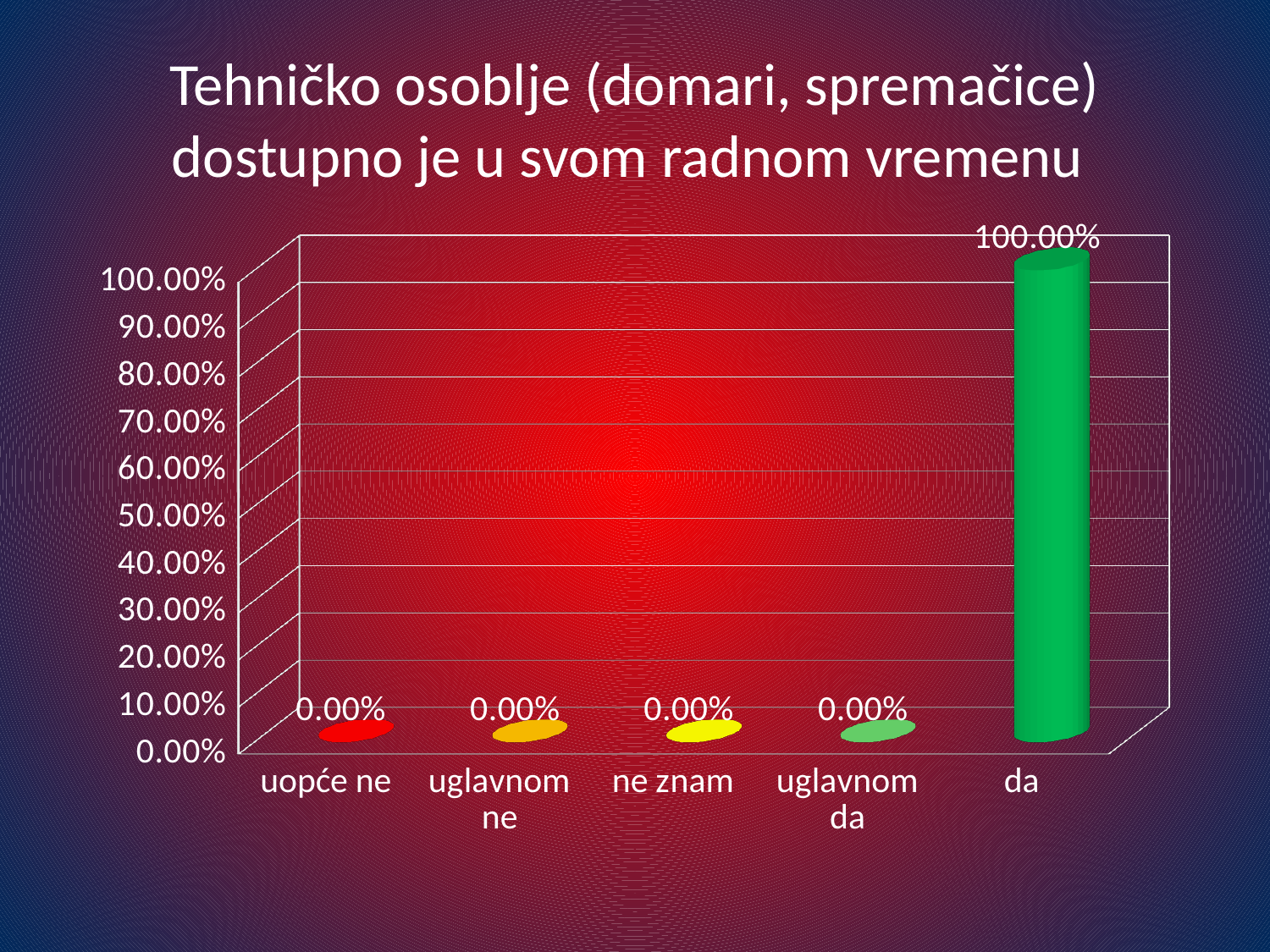
What is the value for "da"? 100.00% What is the value for "uopće ne"? 0.00% What colour is the bar for "da"? green What kind of chart is shown on the slide? bar chart What is the title of the chart? Tehničko osoblje (domari, spremačice) dostupno je u svom radnom vremenu Which is larger, the value for "da" or the value for "uglavnom ne"? da What is the difference between the values for "da" and "uglavnom da"? 100.00% How many categories are shown on the x axis? 5 Is the value for "da" greater or less than 50.00%? greater What is the value for "ne znam"? 0.00% Which category has the highest value? da What is the value for "uglavnom da"? 0.00%